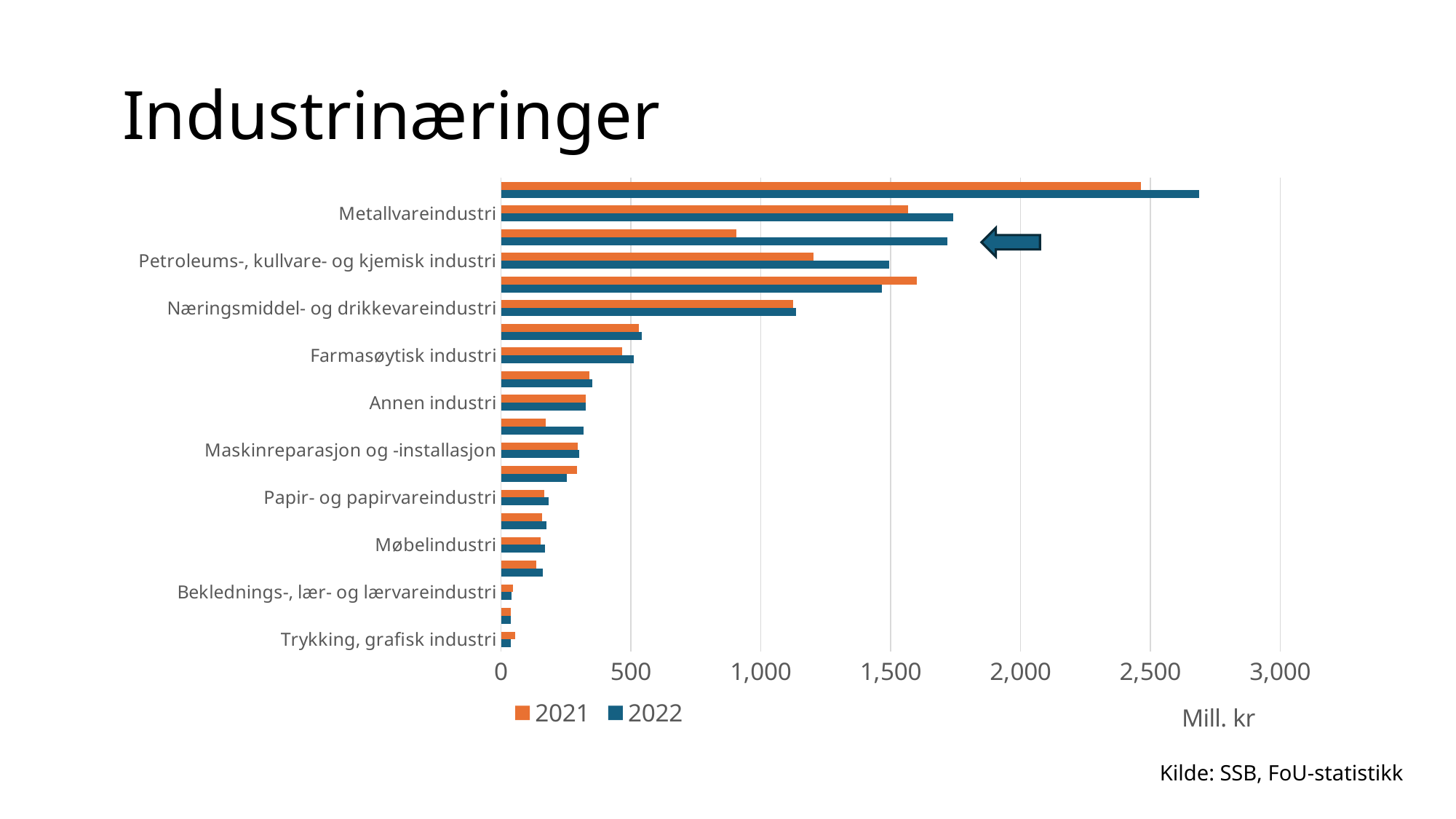
Is the 2022 value for Møbelindustri greater or less than 500? less For Petroleums-, kullvare- og kjemisk industri, which year has the larger value, 2021 or 2022? 2022 Is the 2022 value for Metallvareindustri greater or less than 1,500? greater Which two years are shown in the legend? 2021 and 2022 Which has the larger 2022 value, Metallvareindustri or Farmasøytisk industri? Metallvareindustri How many series does the legend list? 2 What unit is shown on the x axis? Mill. kr For Metallvareindustri, which year has the larger value, 2021 or 2022? 2022 What kind of chart is shown on the slide? bar chart Is the 2021 value for Petroleums-, kullvare- og kjemisk industri greater or less than 1,500? less